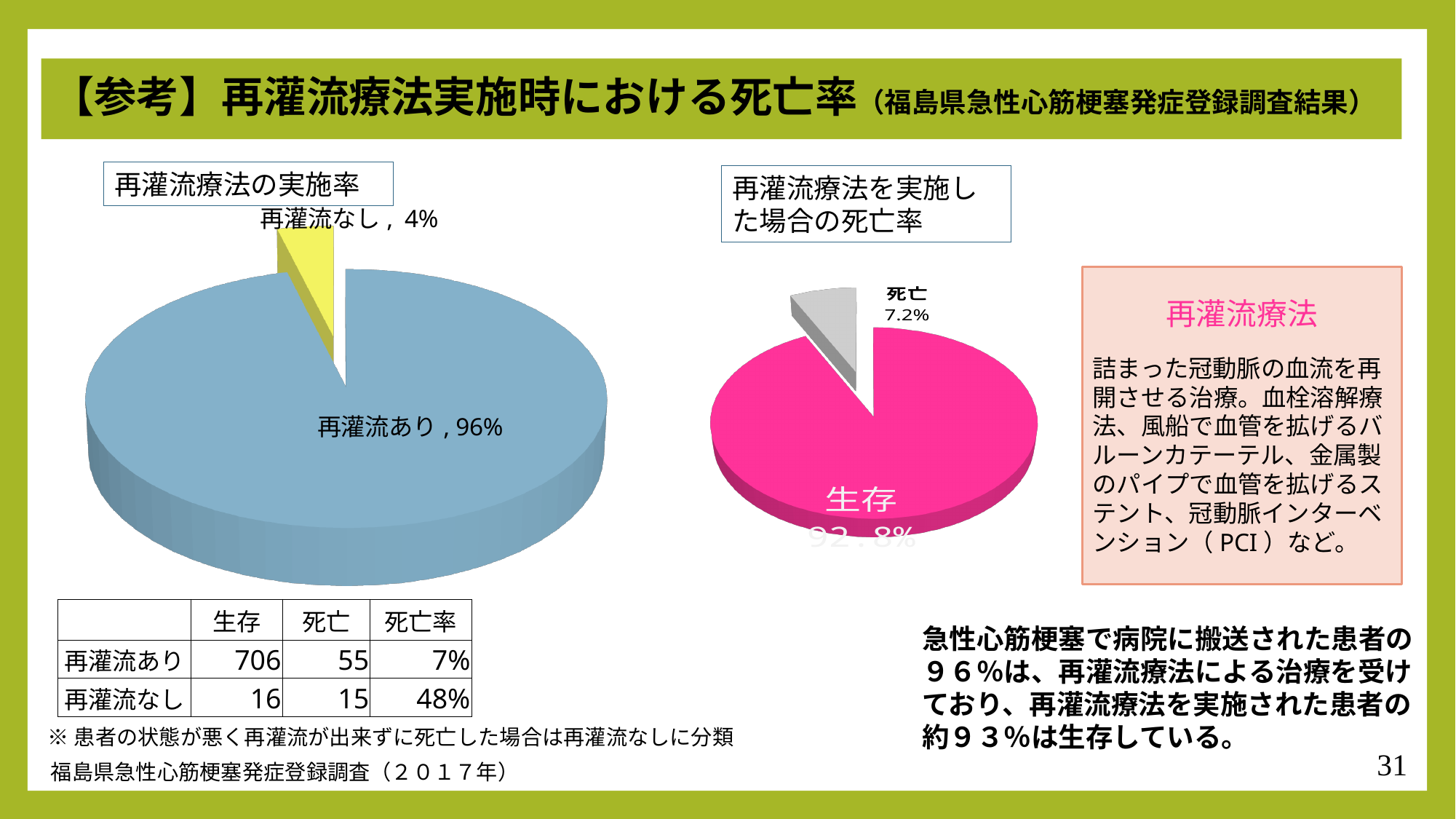
What kind of chart is the right chart titled 再灌流療法を実施した場合の死亡率? Pie chart In the left chart (再灌流療法の実施率), what is the value for 再灌流なし? 4% In the right chart (再灌流療法を実施した場合の死亡率), what is the value for 生存? 92.8% In the left chart (再灌流療法の実施率), what is the value for 再灌流あり? 96% In the right chart (再灌流療法を実施した場合の死亡率), what is the value for 死亡? 7.2% In the left chart (再灌流療法の実施率), what is the difference between the 再灌流あり and 再灌流なし shares? 92 percentage points In the left chart (再灌流療法の実施率), what colour is the 再灌流なし slice? Yellow How many slices does the left chart (再灌流療法の実施率) have? 2 In the right chart (再灌流療法を実施した場合の死亡率), what colour is the 生存 slice? Pink In the left chart (再灌流療法の実施率), which category has the largest slice? 再灌流あり What kind of chart is the left chart titled 再灌流療法の実施率? Pie chart In the right chart (再灌流療法を実施した場合の死亡率), which category has the smallest slice? 死亡